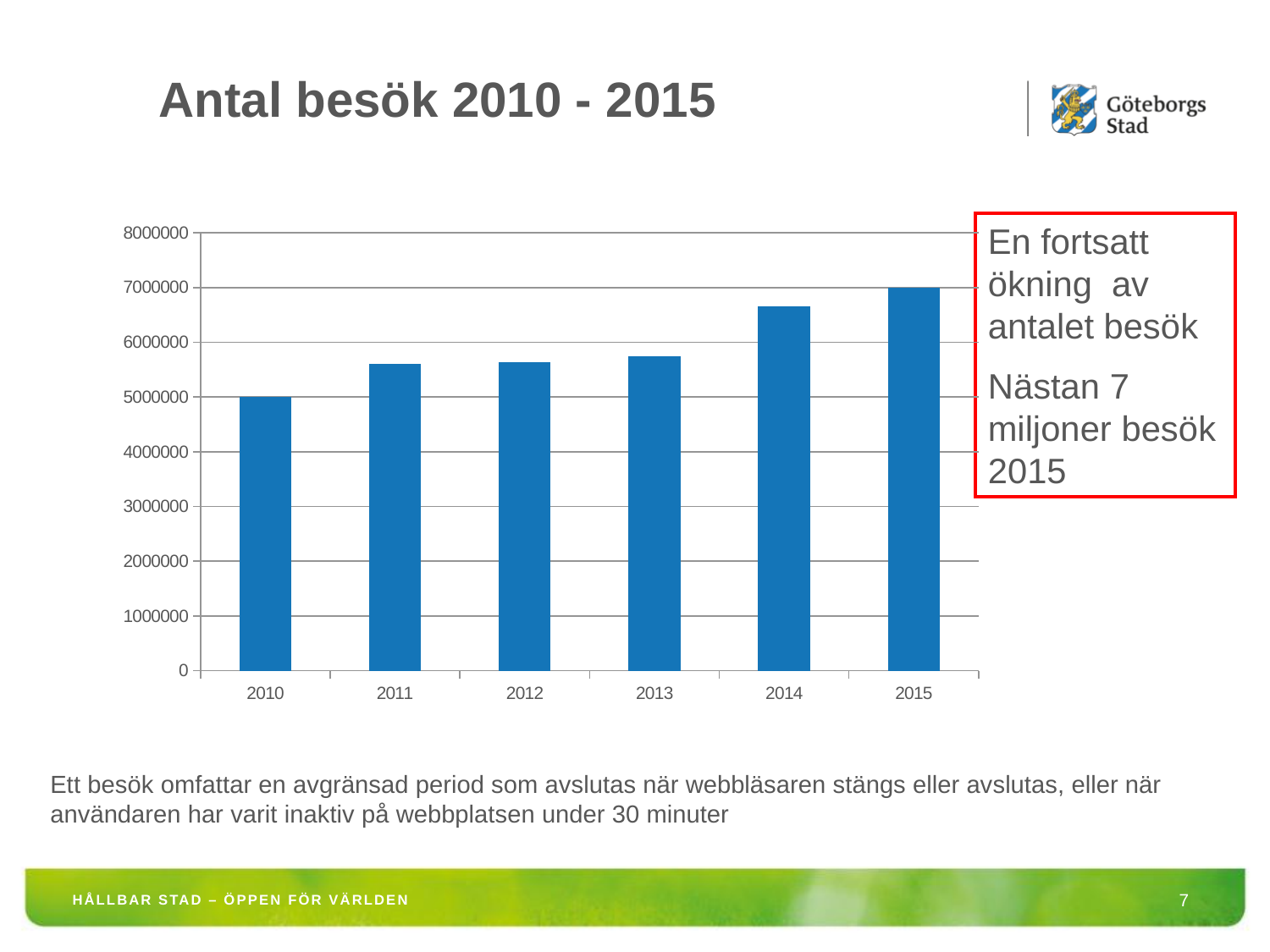
How many years (bars) are shown in the chart? 6 What kind of chart is shown on the slide? bar chart Is the value for 2011 greater or less than 5000000? greater Is the value for 2013 greater or less than 6000000? less What is the title of the slide containing the chart? Antal besök 2010 - 2015 Which year has the highest number of visits in the chart? 2015 Which year has the lowest number of visits in the chart? 2010 Is the value for 2012 greater or less than 6000000? less Which year has more visits, 2010 or 2011? 2011 Do the values rise or fall from 2010 to 2015? rise Which year has more visits, 2013 or 2014? 2014